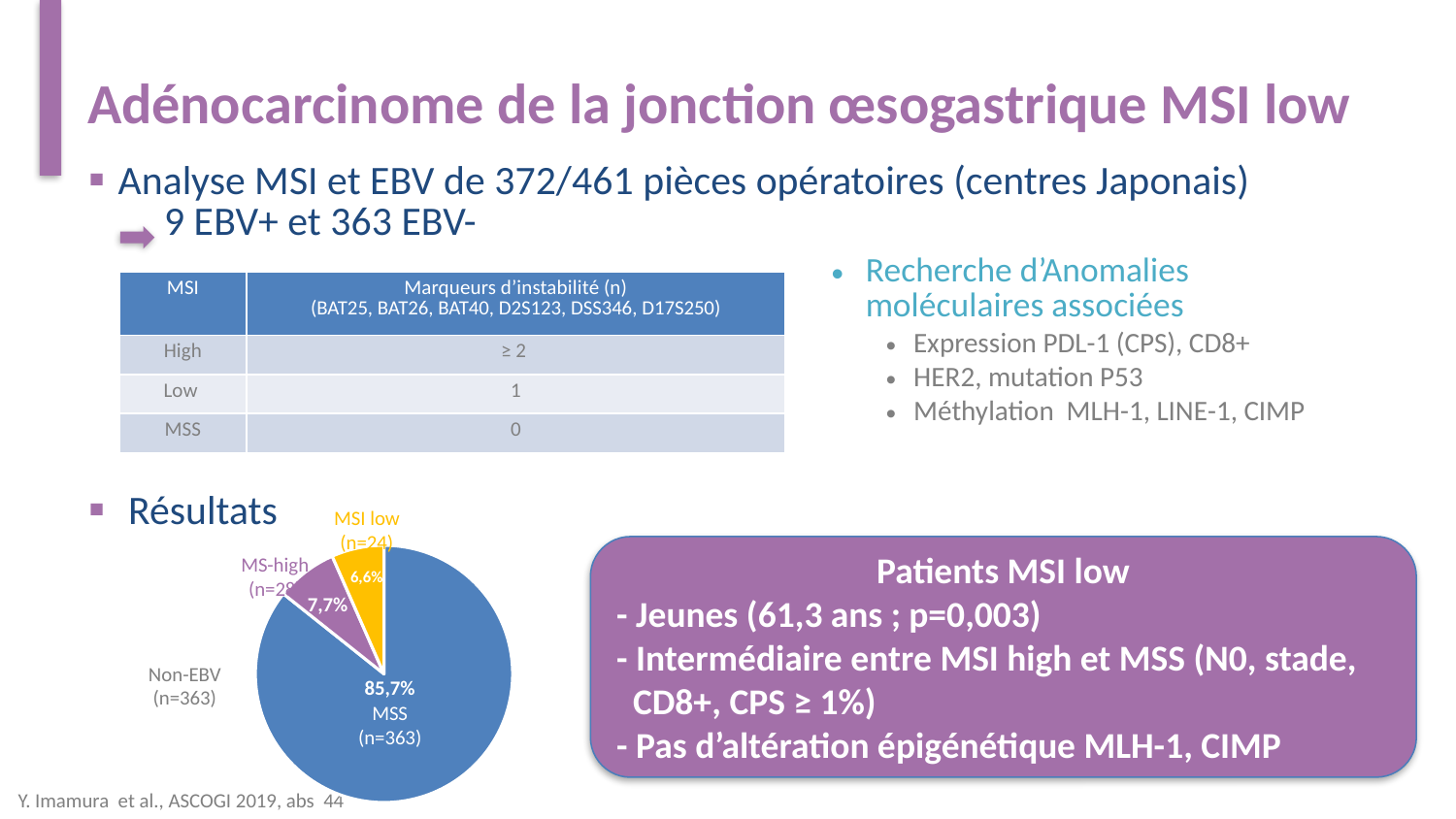
In the pie chart, what percentage is shown for the MSI low slice? 6,6% What is the difference in percentage points between the MSS slice and the MS-high slice in the pie chart? 78 points In the pie chart, which slice is larger: MS-high or MSI low? MS-high In the pie chart, what percentage is shown for the MSS slice? 85,7% What colour is the MSI low slice in the pie chart? yellow What is the n value shown for the MSI low slice in the pie chart? n=24 In the pie chart, what percentage is shown for the MS-high slice? 7,7% Which slice of the pie chart is the largest? MSS What kind of chart is shown under "Résultats"? pie chart How many slices does the pie chart have? 3 What is the difference in percentage points between the MS-high slice and the MSI low slice in the pie chart? 1,1 points Which slice of the pie chart is the smallest? MSI low